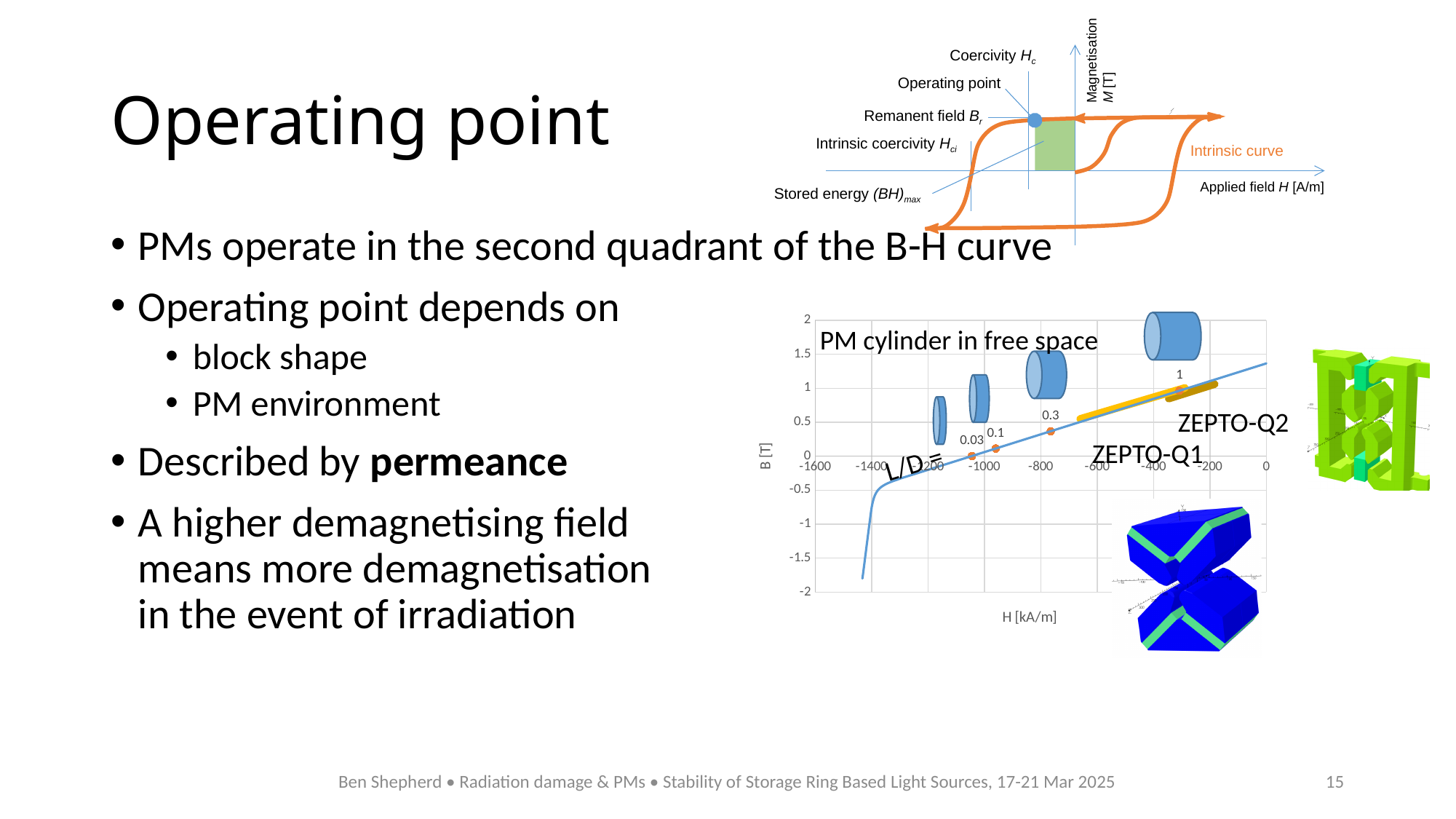
In the 'PM cylinder in free space' chart, which labelled L/D value has the lowest B? 0.03 In the 'PM cylinder in free space' chart, is the B value at the point labelled L/D = 0.03 greater or less than 0.5? less In the 'PM cylinder in free space' chart, which labelled L/D value has the highest B? 1 In the 'PM cylinder in free space' chart, what is the label of the vertical axis? B [T] What kind of chart is the lower chart titled 'PM cylinder in free space'? line chart In the 'PM cylinder in free space' chart, is the B value at the point labelled L/D = 1 greater or less than 0.5? greater In the 'PM cylinder in free space' chart, does B rise or fall as H increases from -1600 towards 0? rises In the 'PM cylinder in free space' chart, which operates at a higher B, ZEPTO-Q1 or ZEPTO-Q2? ZEPTO-Q2 In the 'PM cylinder in free space' chart, what is the label of the horizontal axis? H [kA/m] In the 'PM cylinder in free space' chart, is the H value at the point labelled L/D = 0.3 greater or less than -600? less In the 'PM cylinder in free space' chart, how many L/D values are labelled as points on the curve? 4 In the 'PM cylinder in free space' chart, what is the lowest value shown on the horizontal axis? -1600